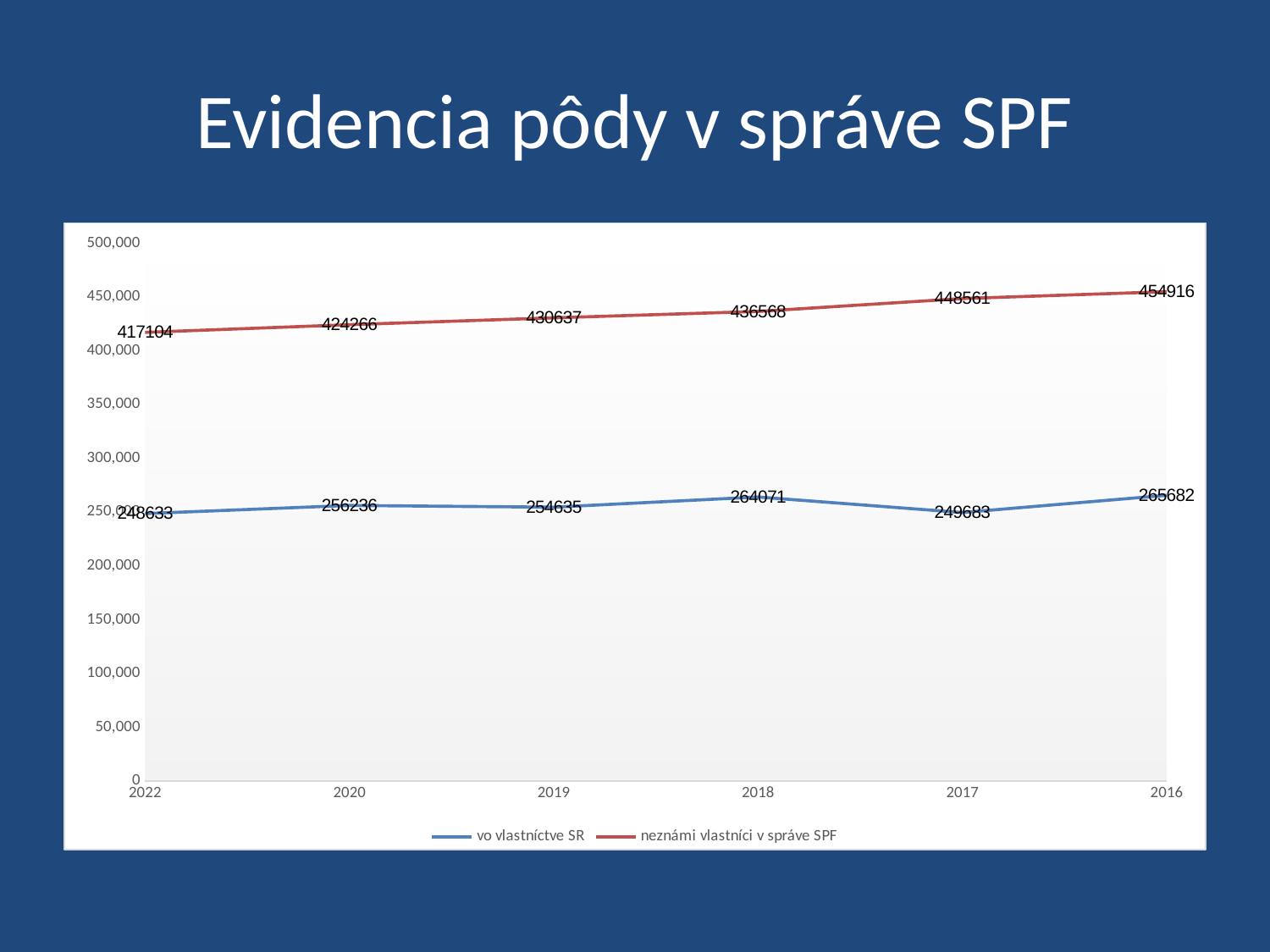
Is the value for 'neznámi vlastníci v správe SPF' in 2019 greater or less than 400,000? greater In which year is the 'neznámi vlastníci v správe SPF' series at its highest? 2016 Does the 'neznámi vlastníci v správe SPF' series rise or fall from left to right along the x axis? rise What is the value for 'neznámi vlastníci v správe SPF' in 2022? 417104 In which year is the 'vo vlastníctve SR' series at its lowest? 2022 Which is larger for 'vo vlastníctve SR': the value in 2020 or the value in 2017? 2020 What type of chart is shown on the slide? line chart What is the value for 'vo vlastníctve SR' in 2018? 264071 How many series does the legend list? 2 What is the difference between the 'neznámi vlastníci v správe SPF' value and the 'vo vlastníctve SR' value in 2017? 198878 How many years are shown on the x axis? 6 What is the value for 'neznámi vlastníci v správe SPF' in 2016? 454916